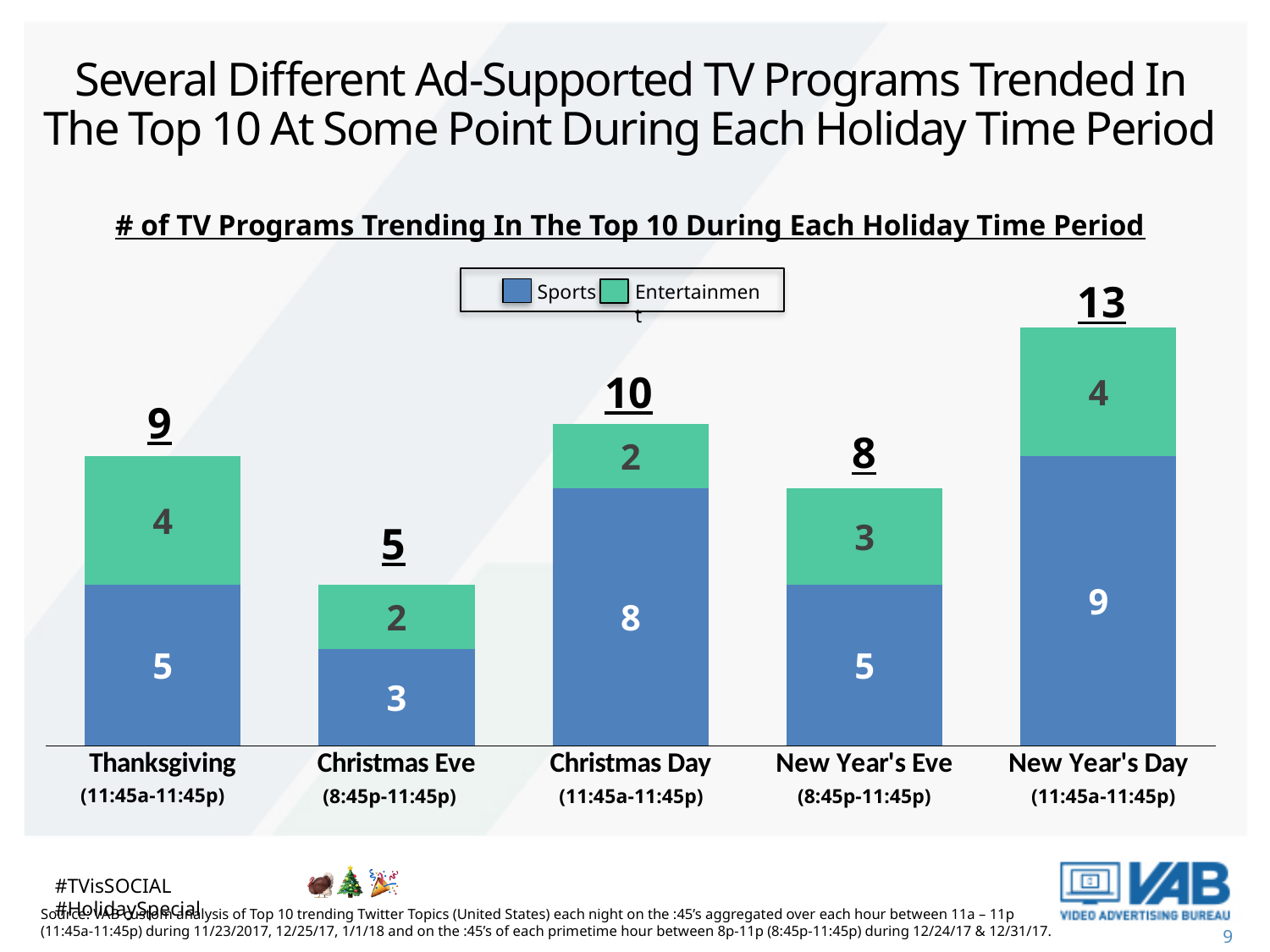
What is the total number of TV programs for Christmas Eve? 5 Which holiday time period has the lowest total number of TV programs? Christmas Eve How many holiday time periods are shown on the x axis? 5 What is the Entertainment value for New Year's Day? 4 What kind of chart is shown on the slide? Stacked bar chart How many series does the legend list? 2 What is the Sports value for Christmas Eve? 3 Which holiday time period has the highest total number of TV programs? New Year's Day Which is larger, the Entertainment value for Thanksgiving or the Entertainment value for Christmas Day? Thanksgiving What is the difference between the Sports values for New Year's Day and Thanksgiving? 4 What is the total number of TV programs for New Year's Day? 13 What is the Sports value for Christmas Day? 8